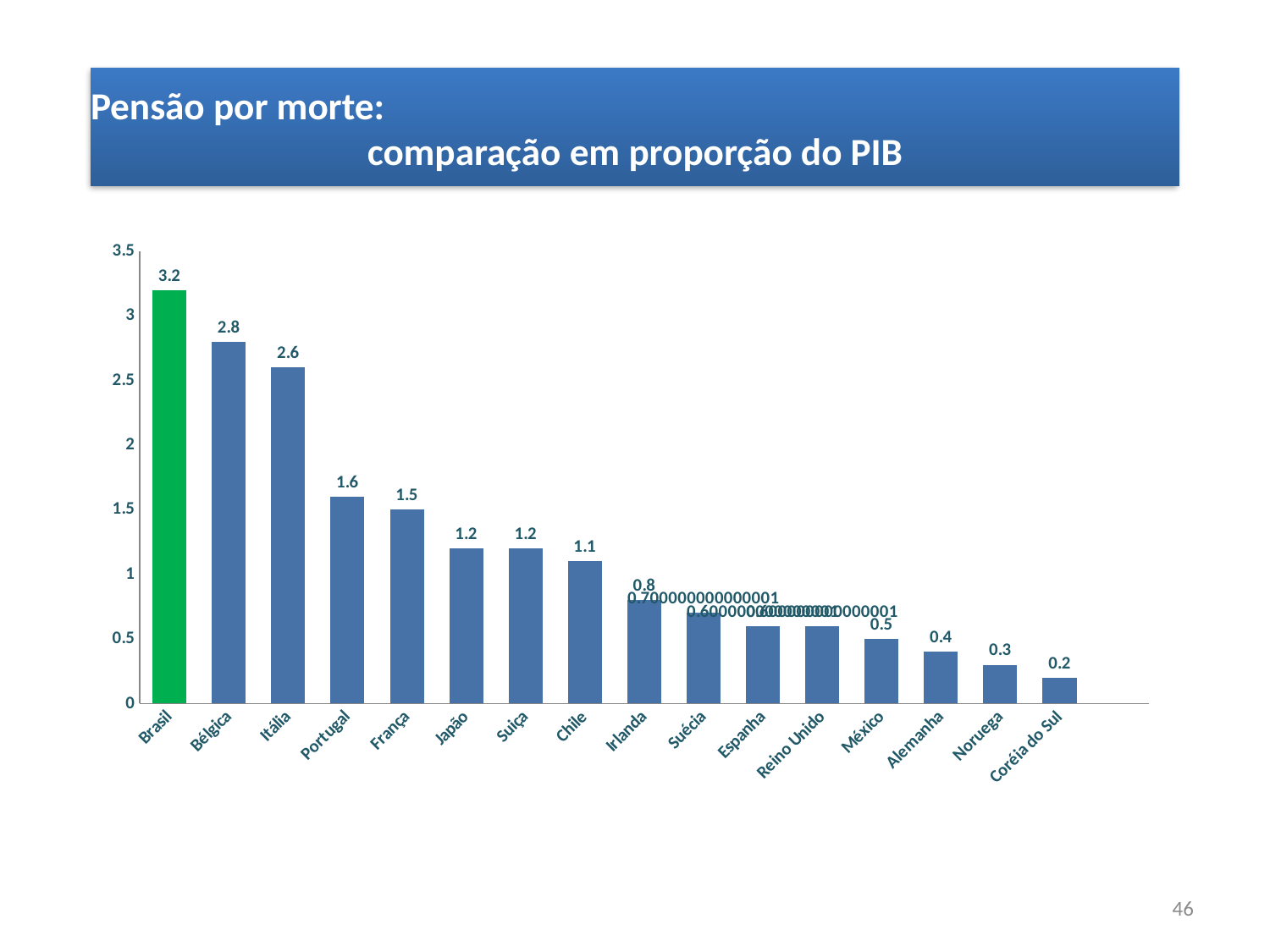
How many countries are shown on the chart? 16 What kind of chart is shown on the slide? bar chart Which country has the lowest value? Coréia do Sul Which country's bar is coloured green? Brasil Which country has the highest value? Brasil What is the difference between the values for Brasil and Bélgica? 0.4 What is the value for Coréia do Sul? 0.2 What is the value for Chile? 1.1 What is the value for Brasil? 3.2 Which is larger, the value for Itália or the value for França? Itália What is the value for Portugal? 1.6 Is the value for Espanha greater or less than 1? less